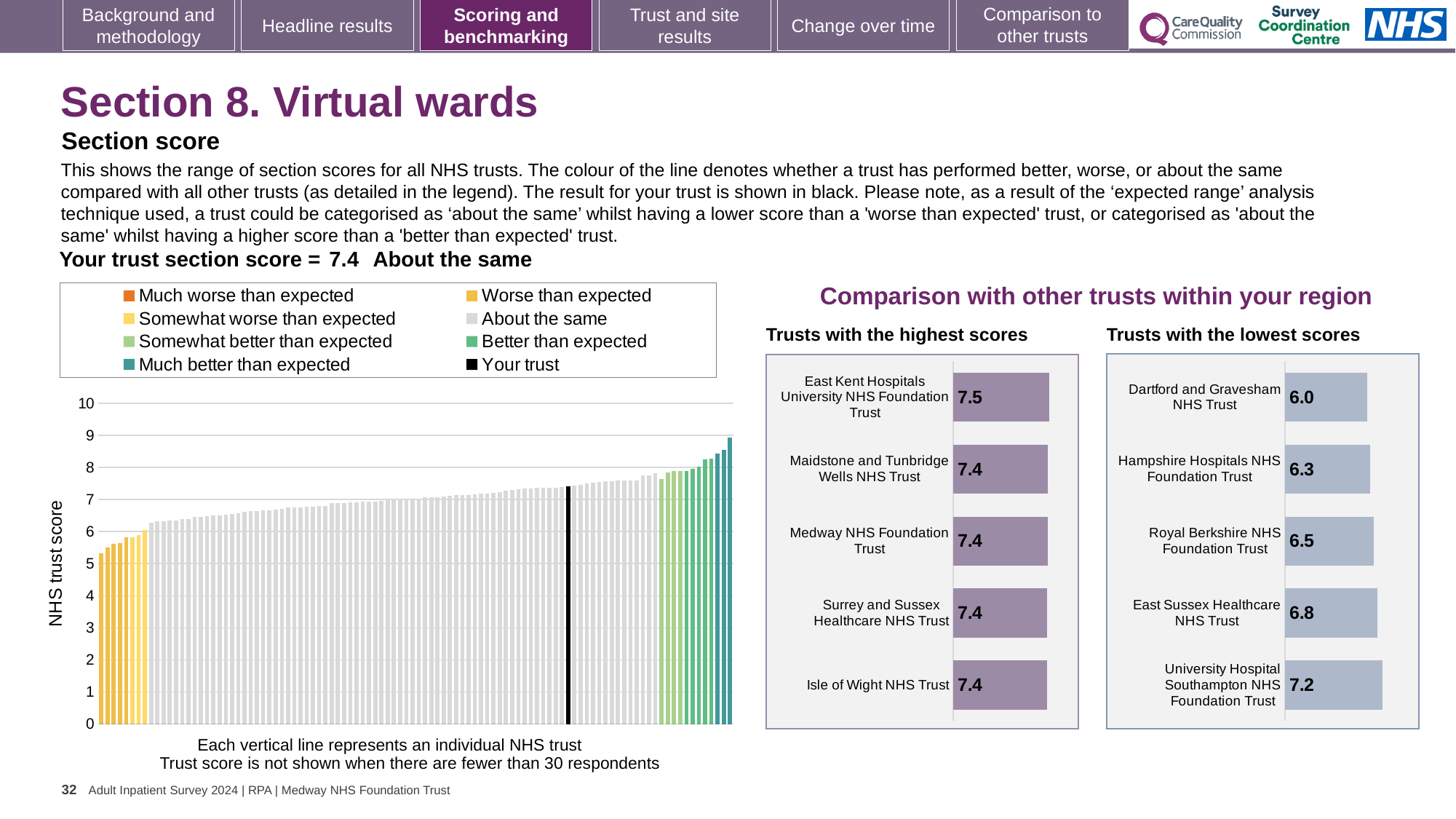
In the 'Trusts with the highest scores' chart, what is the score for East Kent Hospitals University NHS Foundation Trust? 7.5 In the 'Trusts with the lowest scores' chart, which trust has the lowest score? Dartford and Gravesham NHS Trust In the large chart on the left, do the trust scores rise or fall from left to right? Rise What kind of chart is the large chart on the left showing NHS trust scores? Bar chart How many trusts are shown in the 'Trusts with the highest scores' chart? 5 In the 'Trusts with the lowest scores' chart, what is the score for East Sussex Healthcare NHS Trust? 6.8 In the 'Trusts with the lowest scores' chart, which has the higher score: Hampshire Hospitals NHS Foundation Trust or Royal Berkshire NHS Foundation Trust? Royal Berkshire NHS Foundation Trust How many entries does the legend of the large chart on the left list? 8 In the 'Trusts with the highest scores' chart, which trust has the highest score? East Kent Hospitals University NHS Foundation Trust In the 'Trusts with the lowest scores' chart, what is the score for Dartford and Gravesham NHS Trust? 6.0 What is the section score for your trust shown on the slide? 7.4 In the 'Trusts with the lowest scores' chart, what is the difference between the scores of University Hospital Southampton NHS Foundation Trust and Dartford and Gravesham NHS Trust? 1.2